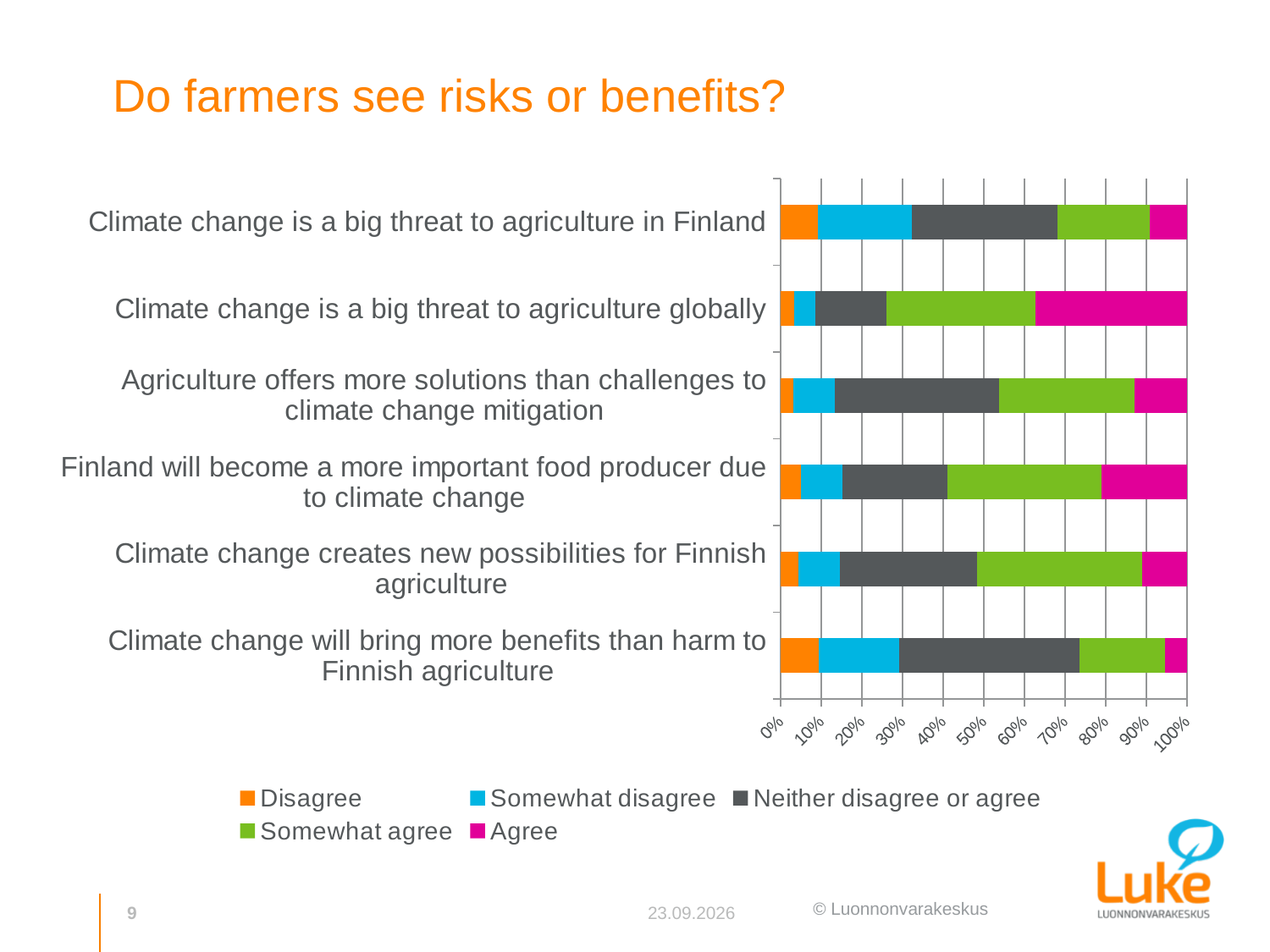
Which response category is shown in orange in the legend? Disagree Is the 'Disagree' share for 'Climate change is a big threat to agriculture in Finland' greater or less than 20%? less Which statement has the smallest 'Agree' share? Climate change will bring more benefits than harm to Finnish agriculture Which statement has the largest 'Agree' share? Climate change is a big threat to agriculture globally Which has the larger 'Agree' share: 'Climate change is a big threat to agriculture globally' or 'Climate change is a big threat to agriculture in Finland'? Climate change is a big threat to agriculture globally Which has the larger 'Somewhat disagree' share: 'Climate change is a big threat to agriculture in Finland' or 'Climate change is a big threat to agriculture globally'? Climate change is a big threat to agriculture in Finland Is the 'Neither disagree or agree' share for 'Climate change will bring more benefits than harm to Finnish agriculture' greater or less than 30%? greater What is the title of the slide containing the chart? Do farmers see risks or benefits? How many series does the legend list? 5 Is the 'Agree' share for 'Climate change is a big threat to agriculture globally' greater or less than 30%? greater How many statements (categories) are plotted in the chart? 6 What kind of chart is shown on the slide? Stacked bar chart